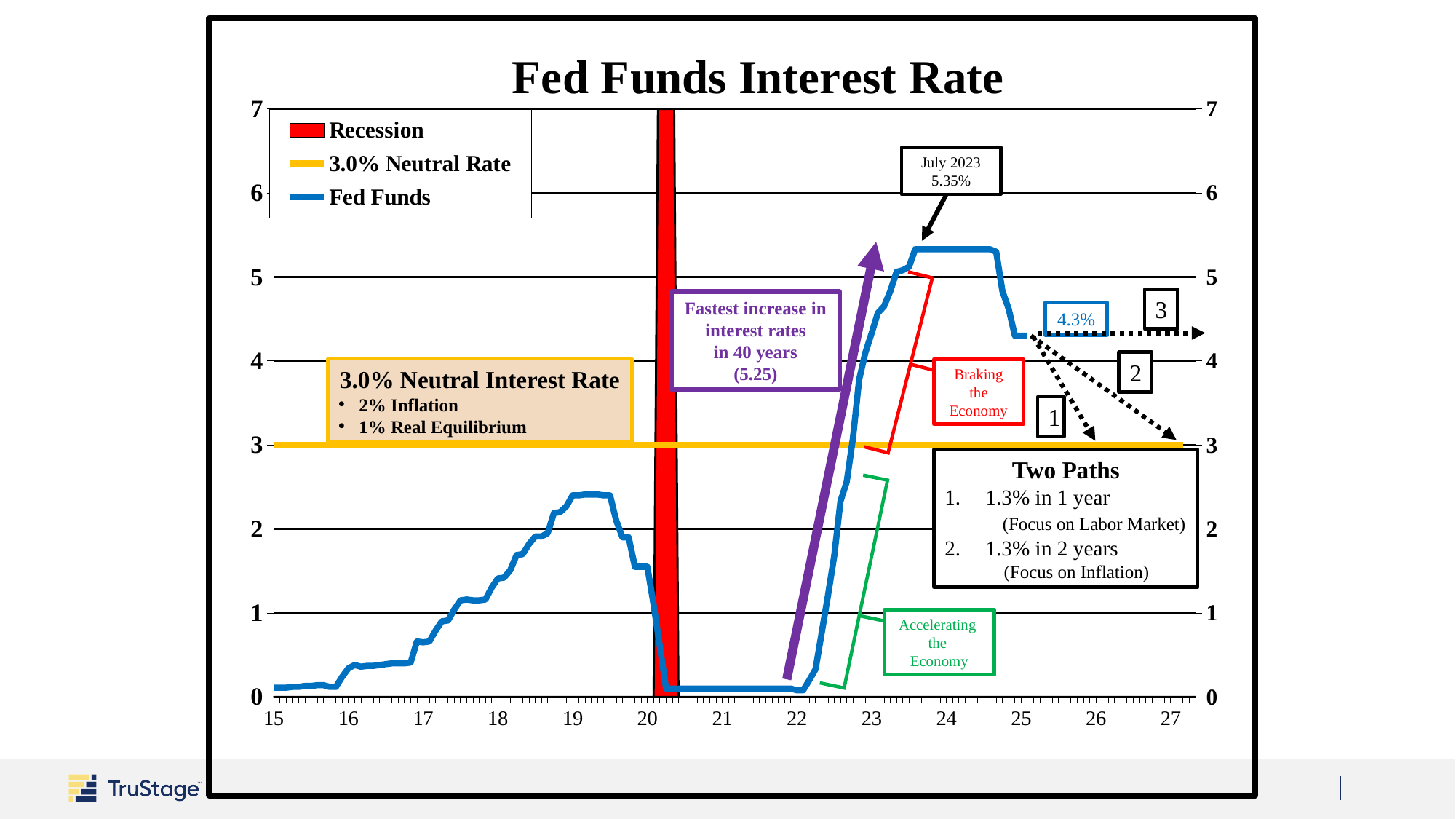
What Fed Funds rate is labeled in the blue box near 2025? 4.3% What is the title of the chart? Fed Funds Interest Rate What is the difference between the labeled 4.3% rate and the 3.0% neutral rate? 1.3% Does the Fed Funds rate rise or fall between 2022 and 2023? rise What is the value of the neutral interest rate shown by the yellow line? 3.0% What Fed Funds rate is labeled for July 2023? 5.35% Is the Fed Funds rate at the start of 2019 greater or less than 2? greater How many entries does the chart's legend list? 3 Which is higher: the Fed Funds peak around 2019 or the peak around 2023-2024? the peak around 2023-2024 What kind of chart is shown on the slide? line chart Is the Fed Funds rate in 2021 greater or less than 1? less What is the difference between the July 2023 rate of 5.35% and the 3.0% neutral rate? 2.35%